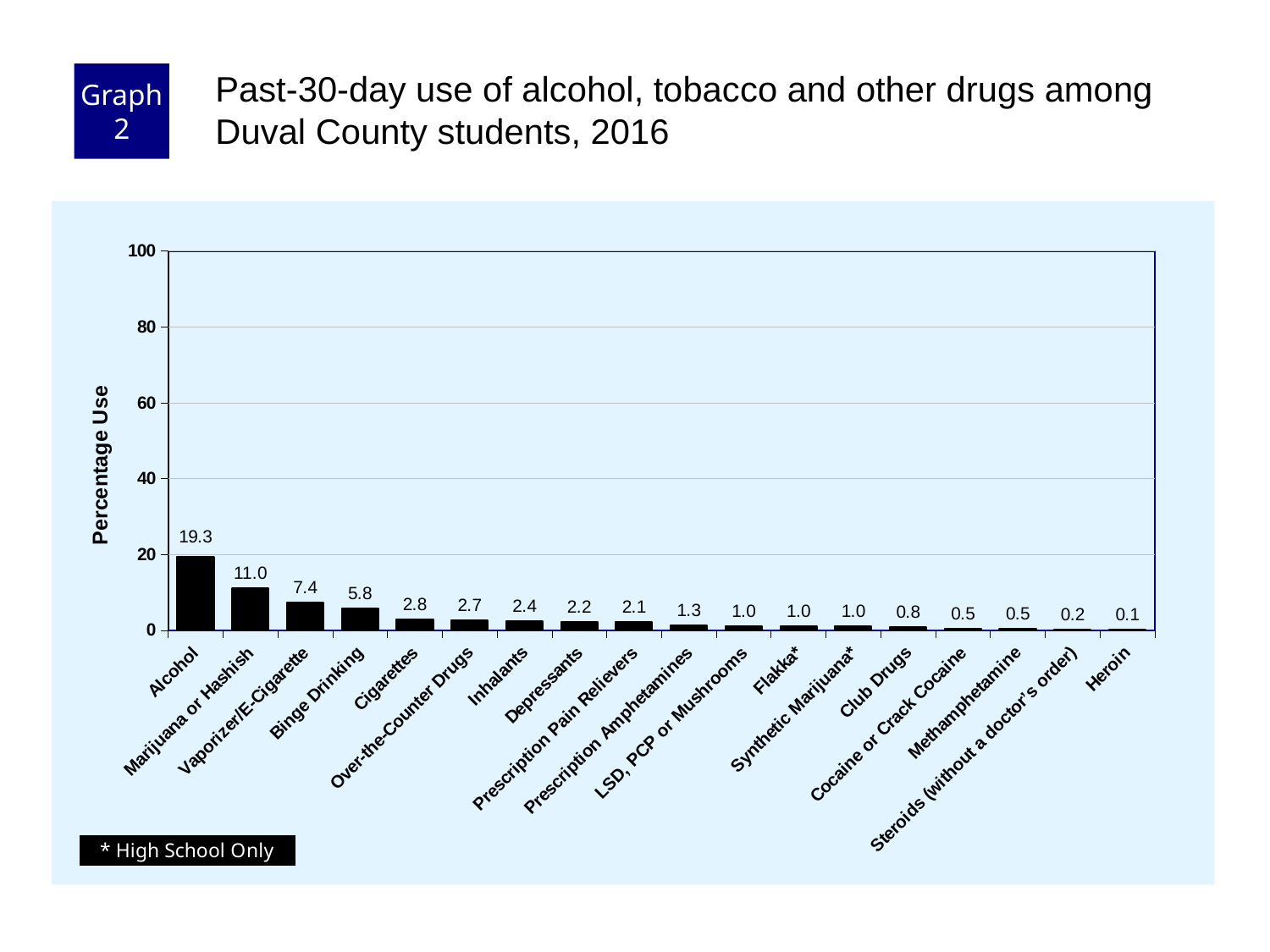
What is the difference between the values for Alcohol and Marijuana or Hashish? 8.3 What is the value for Vaporizer/E-Cigarette? 7.4 What is the value for Inhalants? 2.4 How many categories are shown on the x axis? 18 What is the value for Club Drugs? 0.8 Which category has the lowest value? Heroin What is the value for Alcohol? 19.3 Which category has the highest value? Alcohol What is the difference between the values for Binge Drinking and Cigarettes? 3.0 What kind of chart is this? bar chart Which is larger, the value for Cigarettes or the value for Depressants? Cigarettes Is the value for Marijuana or Hashish greater or less than 20? less